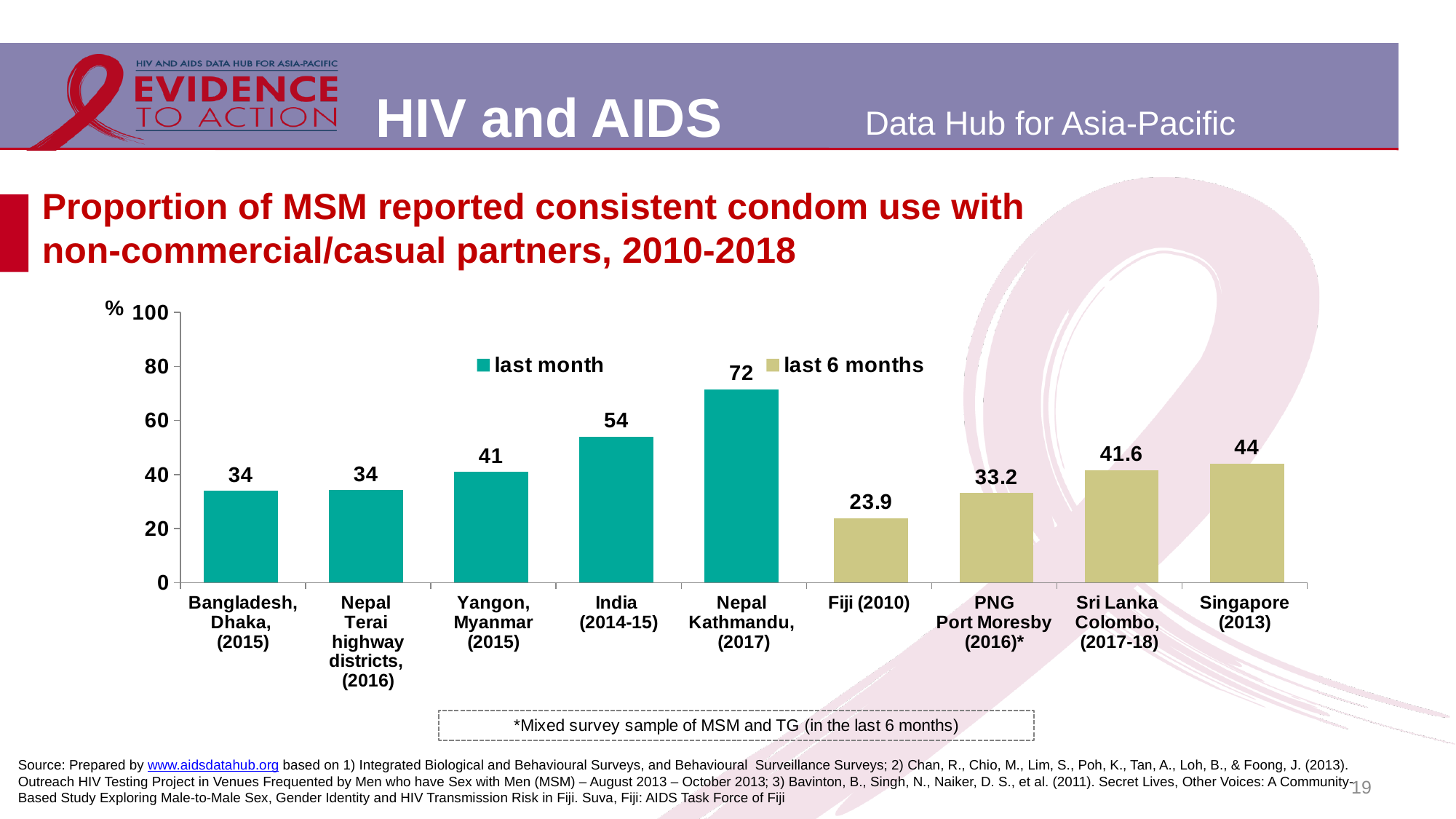
Which is larger, the value for Singapore (2013) or the value for PNG Port Moresby (2016)*? Singapore (2013) Which category has the highest value? Nepal Kathmandu (2017) Which category has the lowest value? Fiji (2010) What is the difference between the values for India (2014-15) and Yangon, Myanmar (2015)? 13 What is the value for Nepal Kathmandu (2017)? 72 Which series does the Bangladesh, Dhaka (2015) bar belong to, according to the legend? last month What is the value for Fiji (2010)? 23.9 Is the value for Nepal Kathmandu (2017) greater or less than 60? greater How many categories are shown on the x axis? 9 What kind of chart is shown on the slide? bar chart What is the value for Sri Lanka Colombo (2017-18)? 41.6 How many series does the legend list? 2